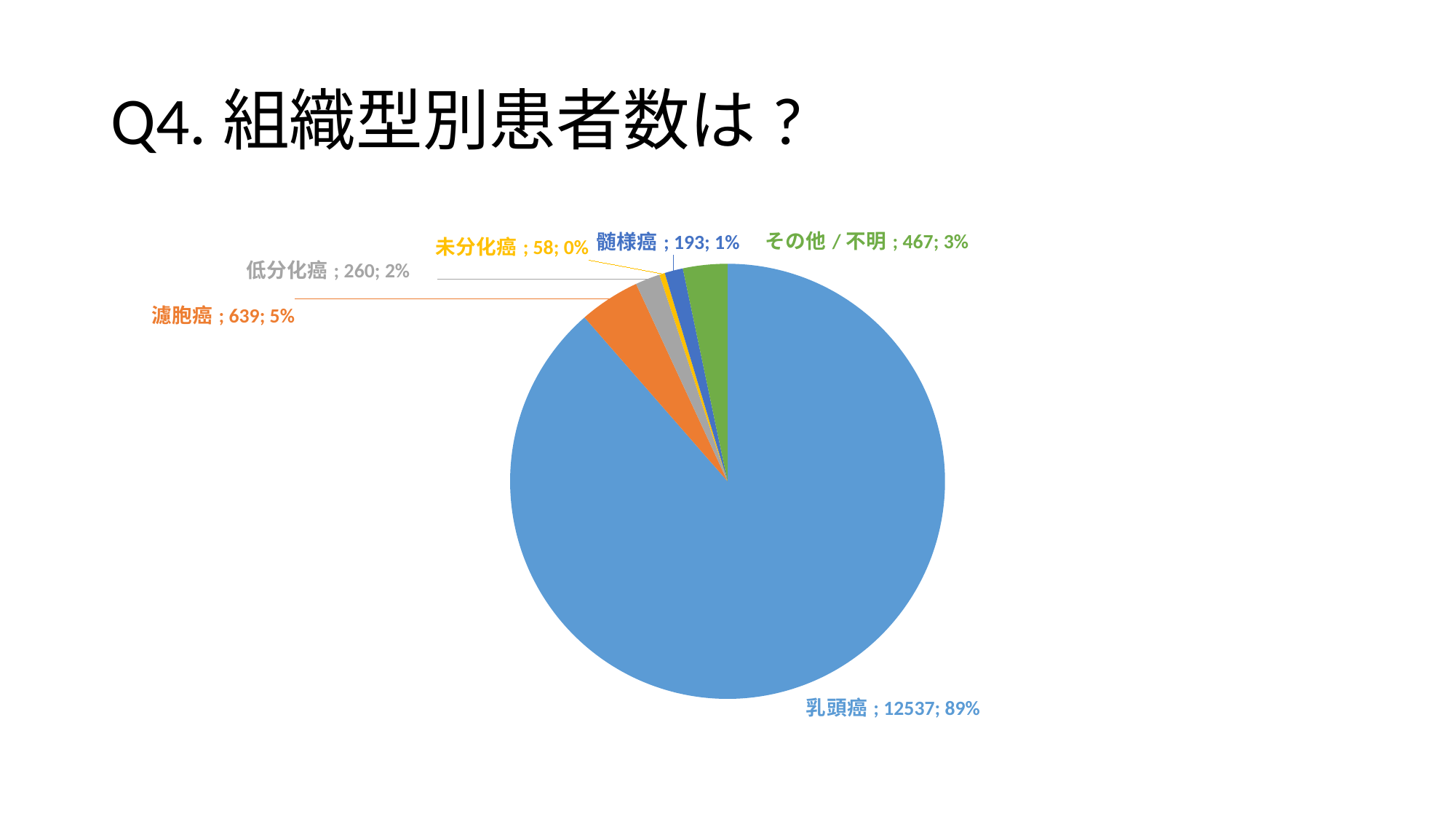
How many patients are in the 髄様癌 category? 193 How many categories are shown in the pie chart? 6 Which category has the largest number of patients? 乳頭癌 What is the difference in patient count between 濾胞癌 and 低分化癌? 379 What kind of chart is shown on the slide? pie chart How many patients are in the 濾胞癌 category? 639 Which has more patients, その他／不明 or 髄様癌? その他／不明 Which category has the smallest number of patients? 未分化癌 What percentage share does その他／不明 have in the pie chart? 3% What is the title of the slide? Q4. 組織型別患者数は？ How many patients are in the 乳頭癌 category? 12537 What percentage share does 乳頭癌 have in the pie chart? 89%